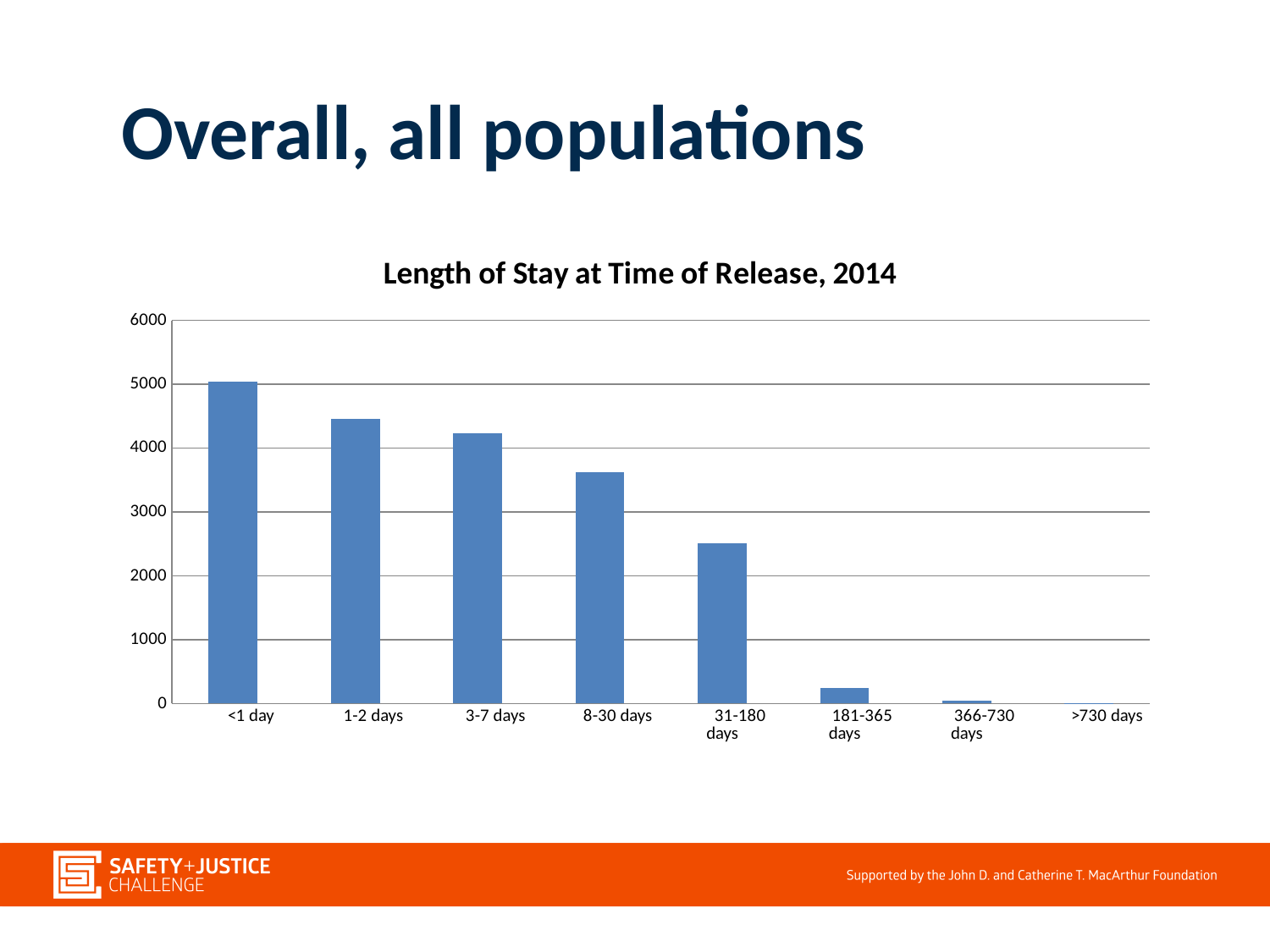
Which length-of-stay category has the highest value? <1 day Is the value for <1 day greater or less than 4000? greater Is the value for 181-365 days greater or less than 1000? less Is the value for 8-30 days greater or less than 4000? less What kind of chart is shown on the slide? bar chart Which has a larger value, 8-30 days or 31-180 days? 8-30 days What is the title of the chart? Length of Stay at Time of Release, 2014 Do the values rise or fall as length of stay increases along the x axis? fall Which length-of-stay category has the lowest value? >730 days How many length-of-stay categories are shown on the x axis? 8